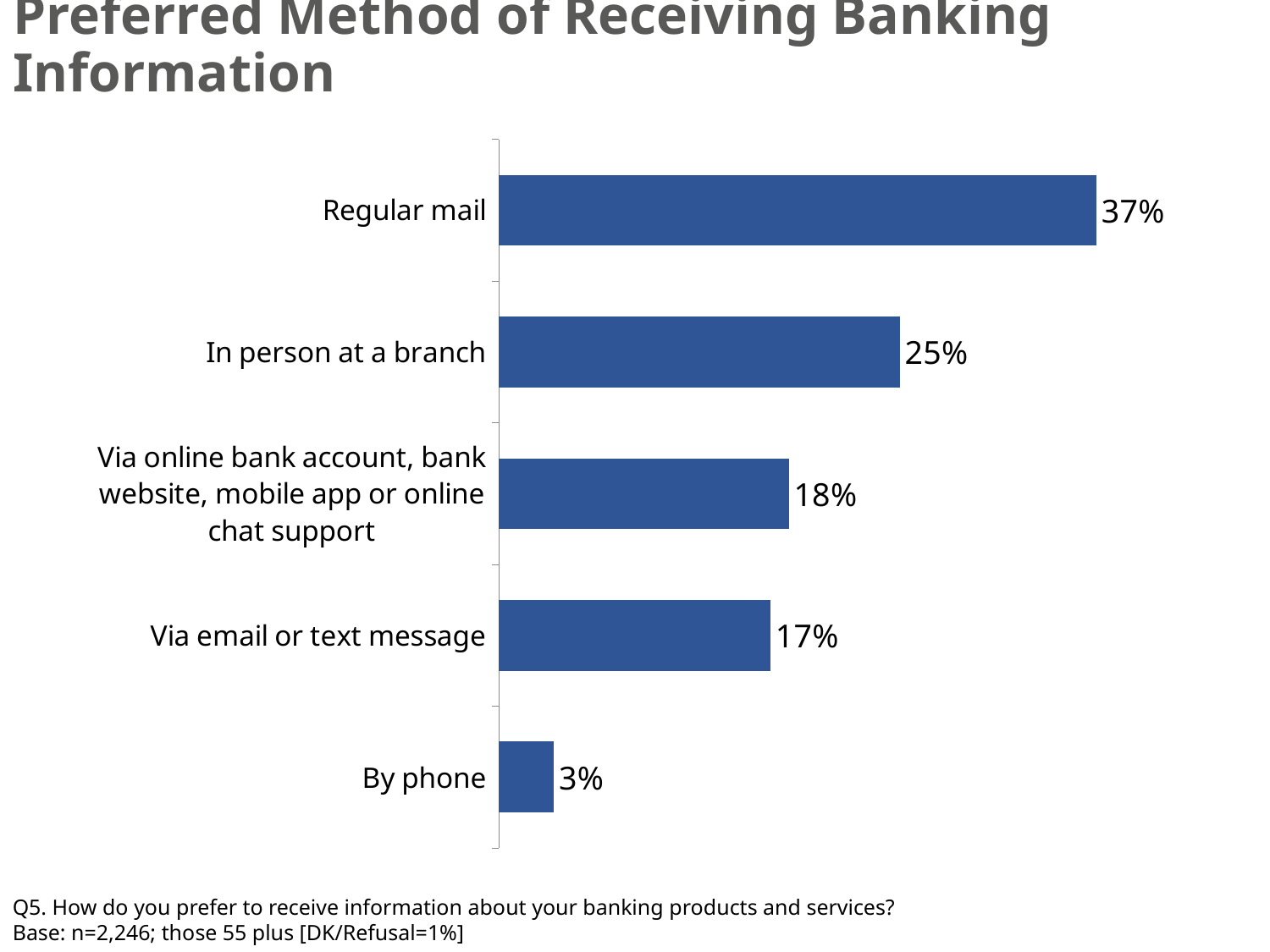
How many categories are shown in the chart? 5 What is the difference in percentage points between 'Regular mail' and 'In person at a branch'? 12 What percentage prefer receiving banking information via email or text message? 17% What is the value for 'In person at a branch'? 25% What is the value for 'By phone'? 3% What type of chart is shown on the slide? Bar chart Which method has the lowest percentage? By phone What is the difference in percentage points between 'Via email or text message' and 'By phone'? 14 Which is larger: the value for 'In person at a branch' or the value for 'Via email or text message'? In person at a branch Which method has the highest percentage? Regular mail What percentage of respondents prefer to receive banking information by regular mail? 37% What is the title of the chart on the slide? Preferred Method of Receiving Banking Information